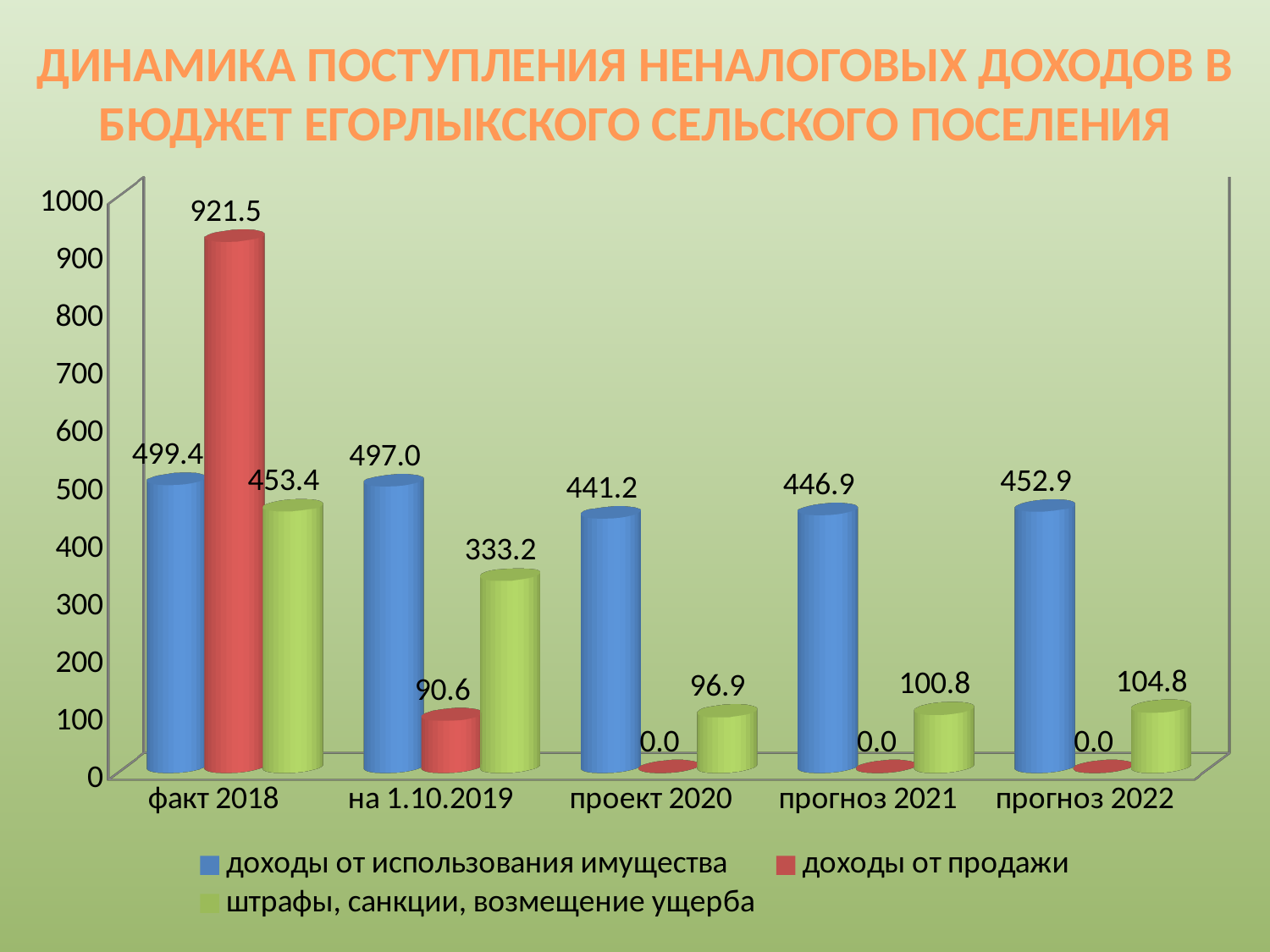
What is the value of "доходы от использования имущества" for "прогноз 2022"? 452.9 How many categories are shown on the x axis? 5 What kind of chart is shown on the slide? bar chart What is the value of "штрафы, санкции, возмещение ущерба" for "на 1.10.2019"? 333.2 Which category has the highest value for "доходы от продажи"? факт 2018 How many series does the legend list? 3 Which is larger for "на 1.10.2019": "доходы от использования имущества" or "штрафы, санкции, возмещение ущерба"? доходы от использования имущества What is the value of "доходы от продажи" for "факт 2018"? 921.5 What is the value of "доходы от продажи" for "прогноз 2021"? 0.0 What is the difference between "доходы от продажи" and "штрафы, санкции, возмещение ущерба" for "факт 2018"? 468.1 Which category has the lowest value for "штрафы, санкции, возмещение ущерба"? проект 2020 Do the values for "штрафы, санкции, возмещение ущерба" rise or fall from "проект 2020" to "прогноз 2022"? rise